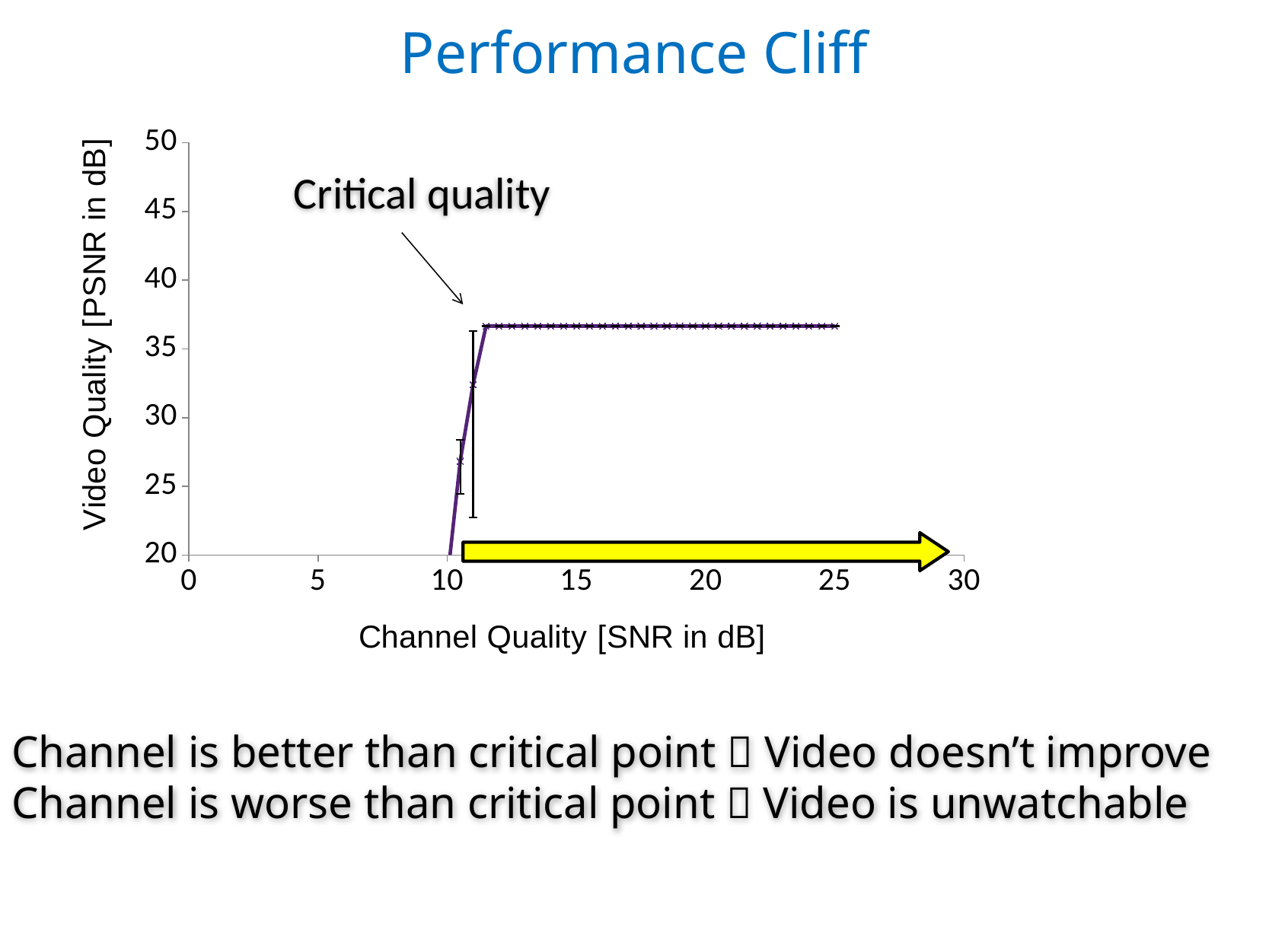
What is the title of the slide's chart? Performance Cliff Is the video quality higher at a channel quality of 20 dB or at about 10.5 dB? 20 dB What is the highest value shown on the x axis? 30 What kind of chart is shown on the slide? Line chart What is the highest value shown on the y axis? 50 Is the video quality at a channel quality of 20 dB greater or less than 30? greater Is the video quality at a channel quality of 20 dB greater or less than 40? less Is the video quality at a channel quality of 15 dB greater or less than 35? greater Does the video quality rise or fall as channel quality increases from 10 dB to 12 dB? Rises Does the video quality rise, fall, or stay flat as channel quality increases from 15 dB to 25 dB? Stays flat